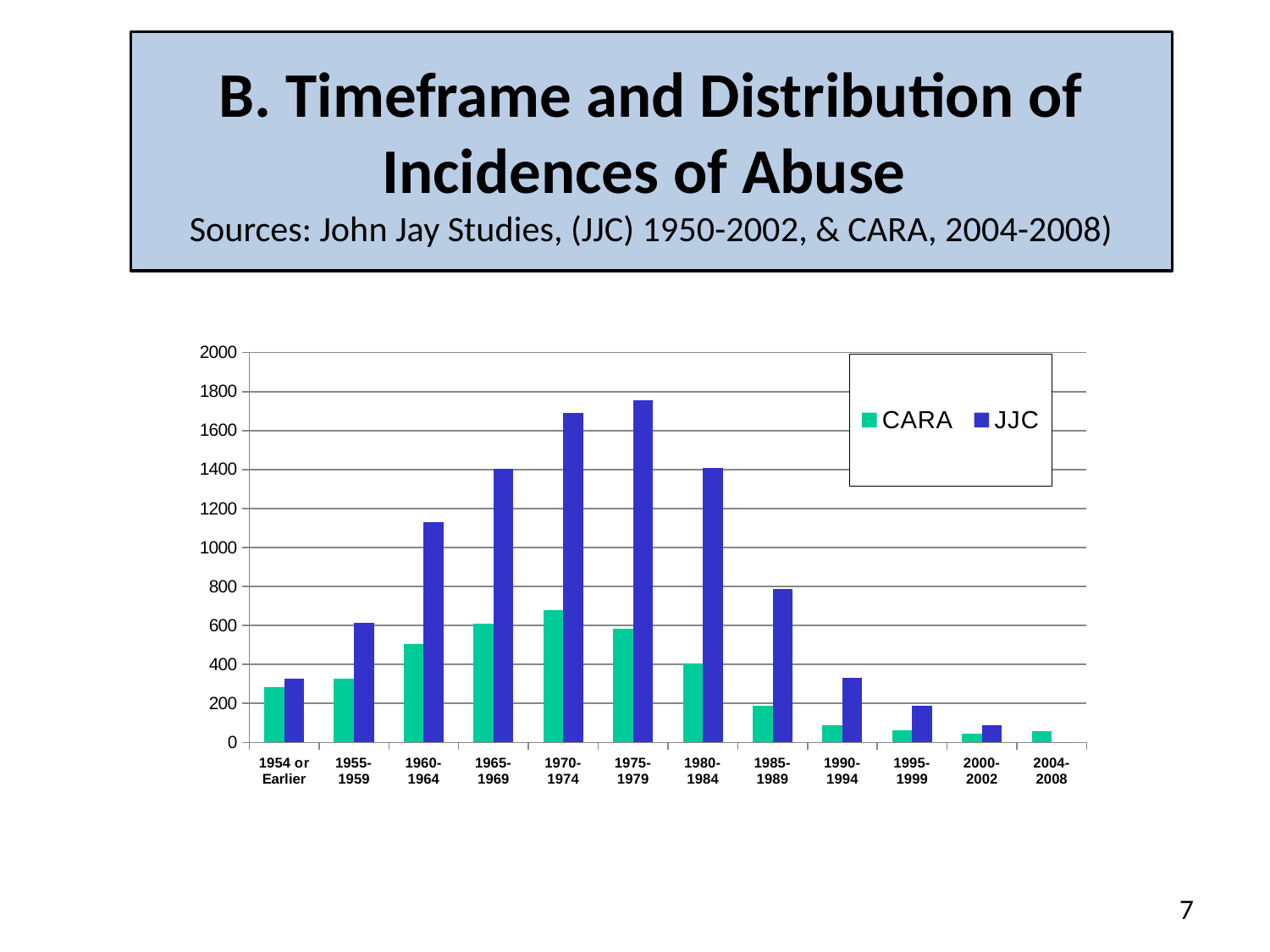
Which is larger, the CARA value for 1960-1964 or the CARA value for 1985-1989? 1960-1964 Is the JJC value for 1960-1964 greater or less than 1000? greater What kind of chart is shown on the slide? bar chart How many series does the legend list? 2 Which time period has the highest CARA value? 1970-1974 Is the JJC value for 1985-1989 greater or less than 1000? less Is the JJC value for 1975-1979 greater or less than 1600? greater For 1965-1969, which series has the larger value, CARA or JJC? JJC How many time-period categories are shown on the x axis? 12 Which time period has the highest JJC value? 1975-1979 Do the JJC values rise or fall from 1975-1979 through 2000-2002? fall